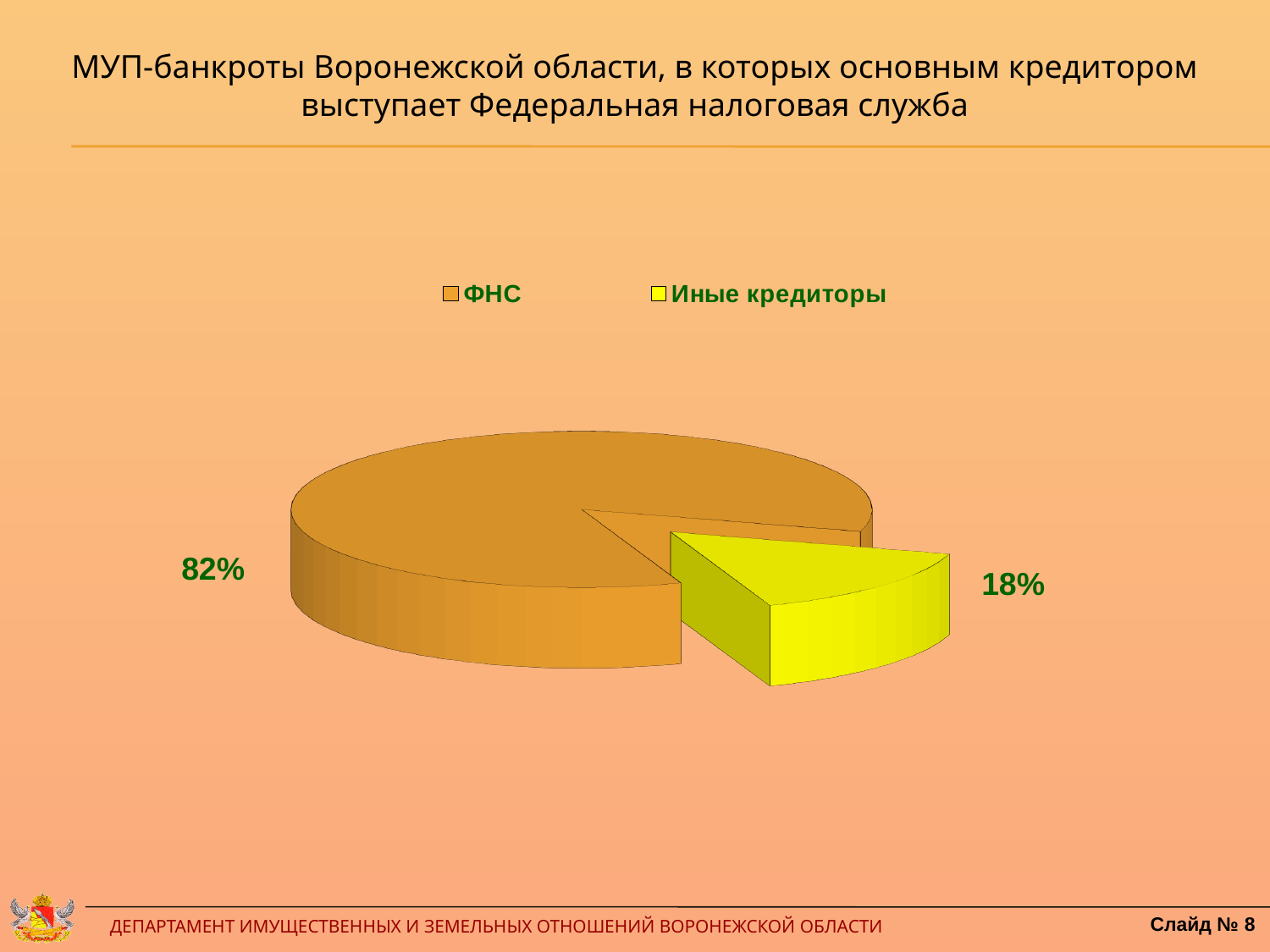
What share of the pie does Иные кредиторы account for? 18% Which category has the smallest slice of the pie? Иные кредиторы What kind of chart is shown on the slide? Pie chart How many entries does the legend list? 2 Which is larger, the slice for ФНС or the slice for Иные кредиторы? ФНС What is the difference in percentage points between the ФНС slice and the Иные кредиторы slice? 64 How many slices does the pie chart have? 2 What share of the pie does ФНС account for? 82% Which slice is pulled out (exploded) from the pie? Иные кредиторы Which category has the largest slice of the pie? ФНС What colour is the slice for Иные кредиторы? Yellow